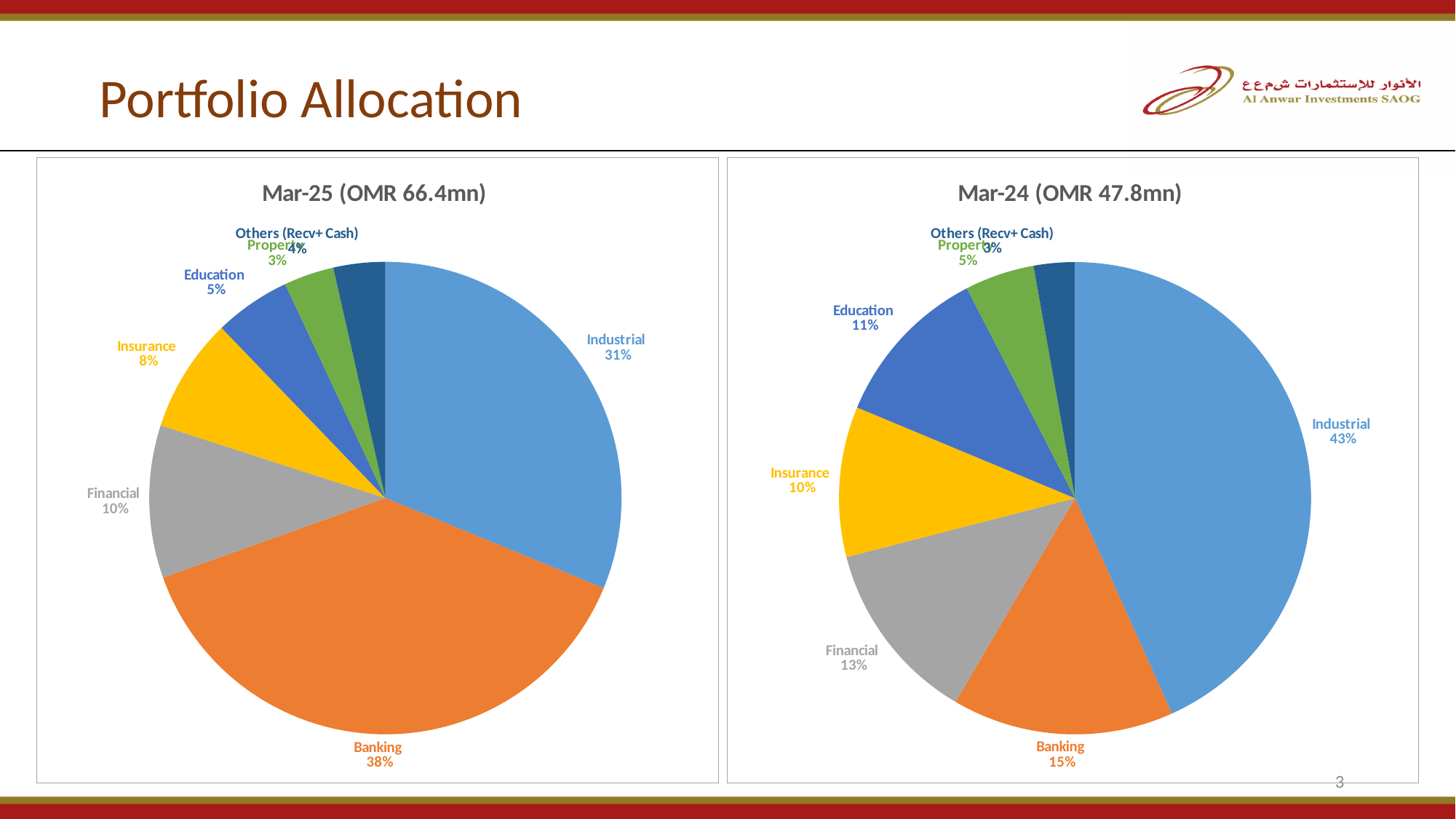
In the Mar-24 (OMR 47.8mn) chart, what share does Industrial have? 43% In the Mar-24 (OMR 47.8mn) chart, which category has the smallest share? Others (Recv+ Cash) In the Mar-24 (OMR 47.8mn) chart, what is the difference between the Industrial and Banking shares? 28% How many categories are shown in the Mar-24 (OMR 47.8mn) chart? 7 In the Mar-25 (OMR 66.4mn) chart, what share does Banking have? 38% In the Mar-25 (OMR 66.4mn) chart, which is larger, Financial or Insurance? Financial In the Mar-25 (OMR 66.4mn) chart, which category has the largest share? Banking What type of chart is the Mar-25 (OMR 66.4mn) chart? Pie chart In the Mar-24 (OMR 47.8mn) chart, what is the value for Education? 11% In the Mar-25 (OMR 66.4mn) chart, what is the value for Insurance? 8% What is the title of the chart on the right side of the slide? Mar-24 (OMR 47.8mn) In the Mar-25 (OMR 66.4mn) chart, which category has the smallest share? Property